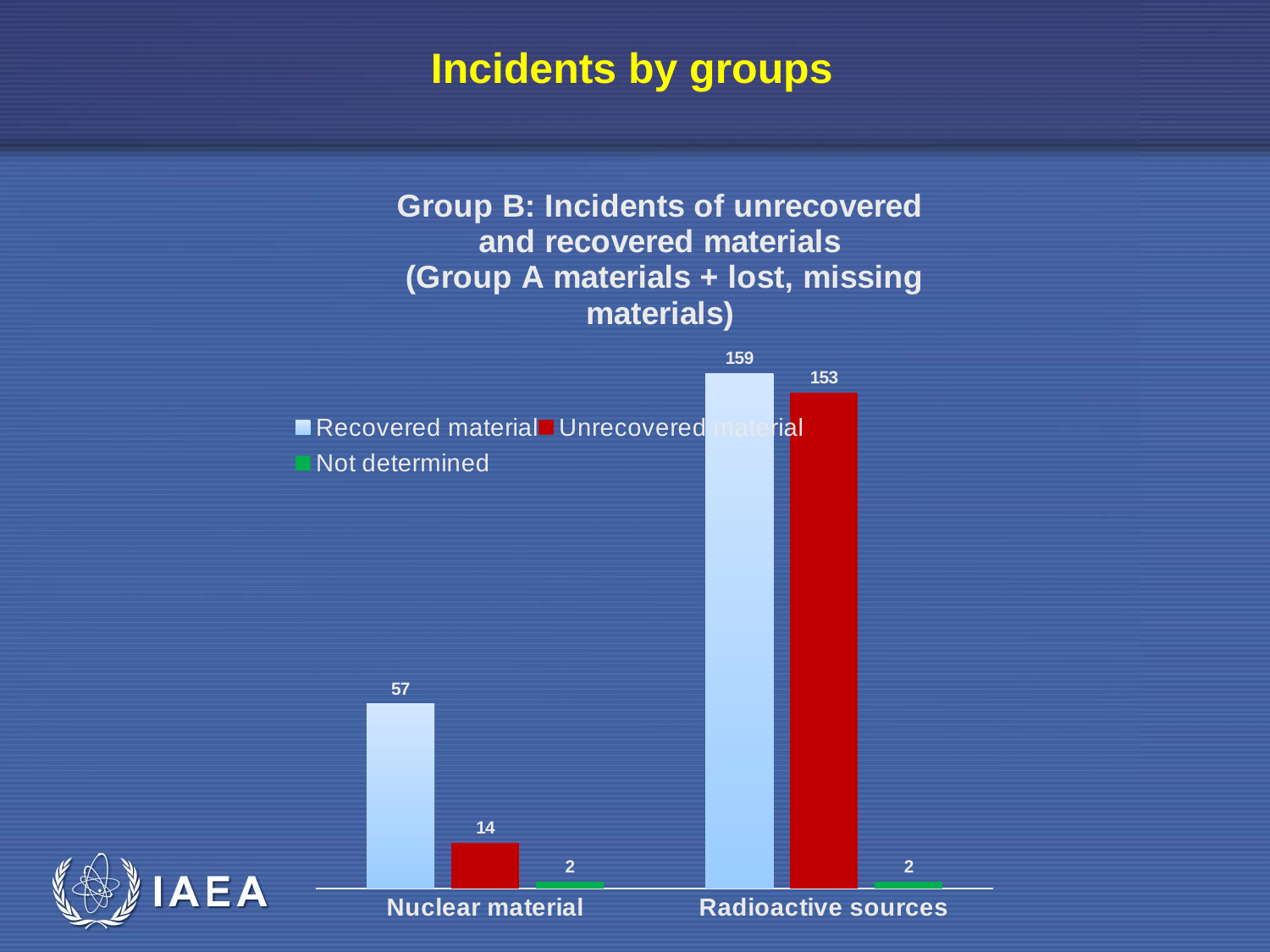
What is the value for Recovered material in the Nuclear material category? 57 What is the value for Unrecovered material in the Radioactive sources category? 153 Which category has the highest value for Unrecovered material? Radioactive sources What is the difference between Recovered material and Unrecovered material in the Nuclear material category? 43 Which is larger: Unrecovered material for Nuclear material or Unrecovered material for Radioactive sources? Radioactive sources How many series does the legend list? 3 How many categories are shown on the x axis? 2 What is the difference between Recovered material for Radioactive sources and Recovered material for Nuclear material? 102 What is the value for Not determined in the Nuclear material category? 2 Which series has the lowest value in the Radioactive sources category? Not determined What kind of chart is shown on the slide? Bar chart What is the value for Recovered material in the Radioactive sources category? 159